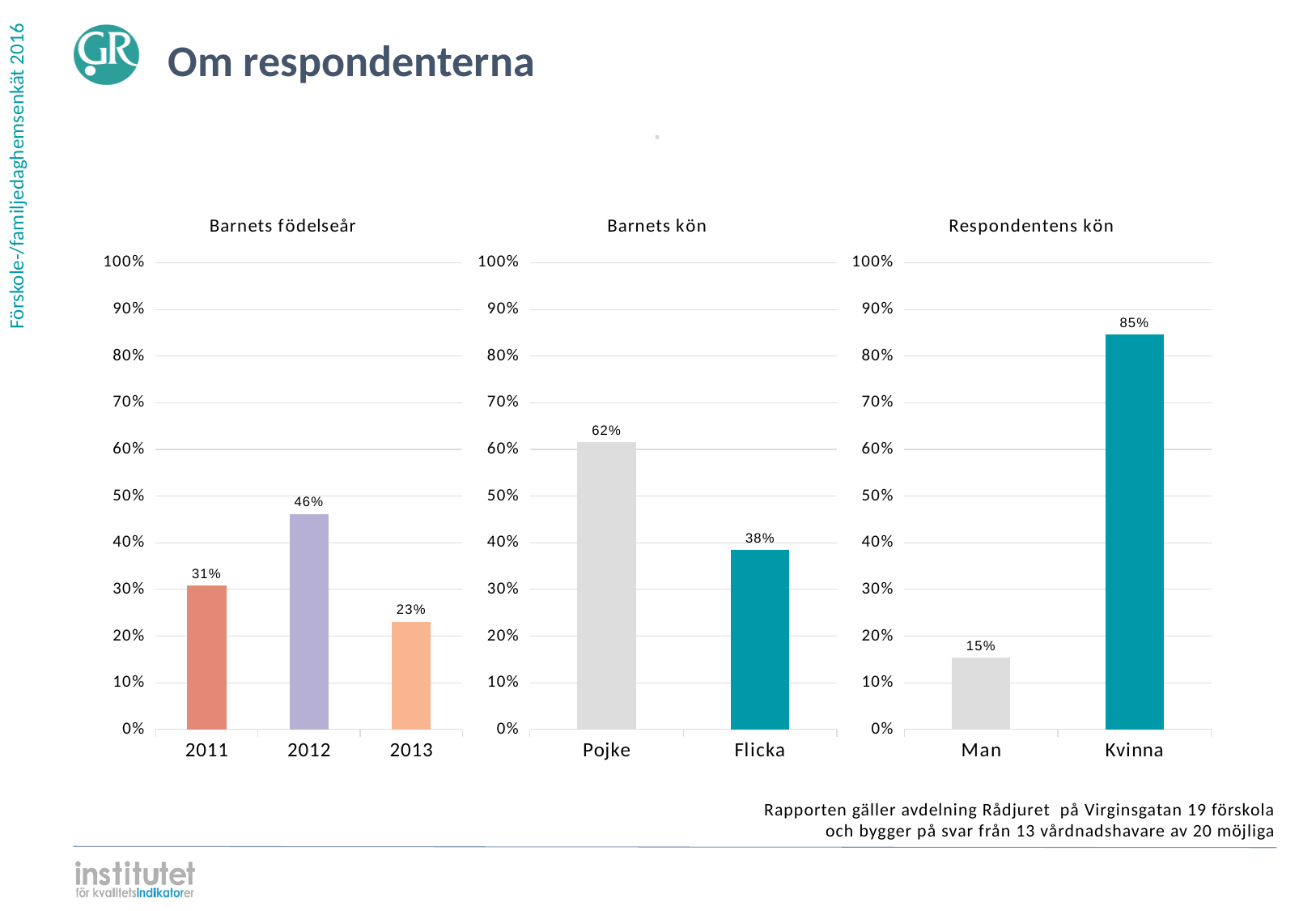
In the 'Barnets födelseår' chart, how many categories are shown on the x axis? 3 What is the title of the middle chart on the slide? Barnets kön In the 'Barnets födelseår' chart, what is the difference between the values for 2012 and 2011? 15% In the 'Respondentens kön' chart, what is the value for Man? 15% In the 'Barnets födelseår' chart, which year has the lowest value? 2013 In the 'Respondentens kön' chart, is the value for Man greater or less than 20%? less In the 'Respondentens kön' chart, what is the value for Kvinna? 85% In the 'Barnets kön' chart, what is the value for Pojke? 62% What kind of chart is the 'Respondentens kön' chart? Bar chart In the 'Barnets kön' chart, which is larger, Pojke or Flicka? Pojke In the 'Barnets födelseår' chart, what is the value for 2012? 46% In the 'Barnets kön' chart, what is the difference between Pojke and Flicka? 24%